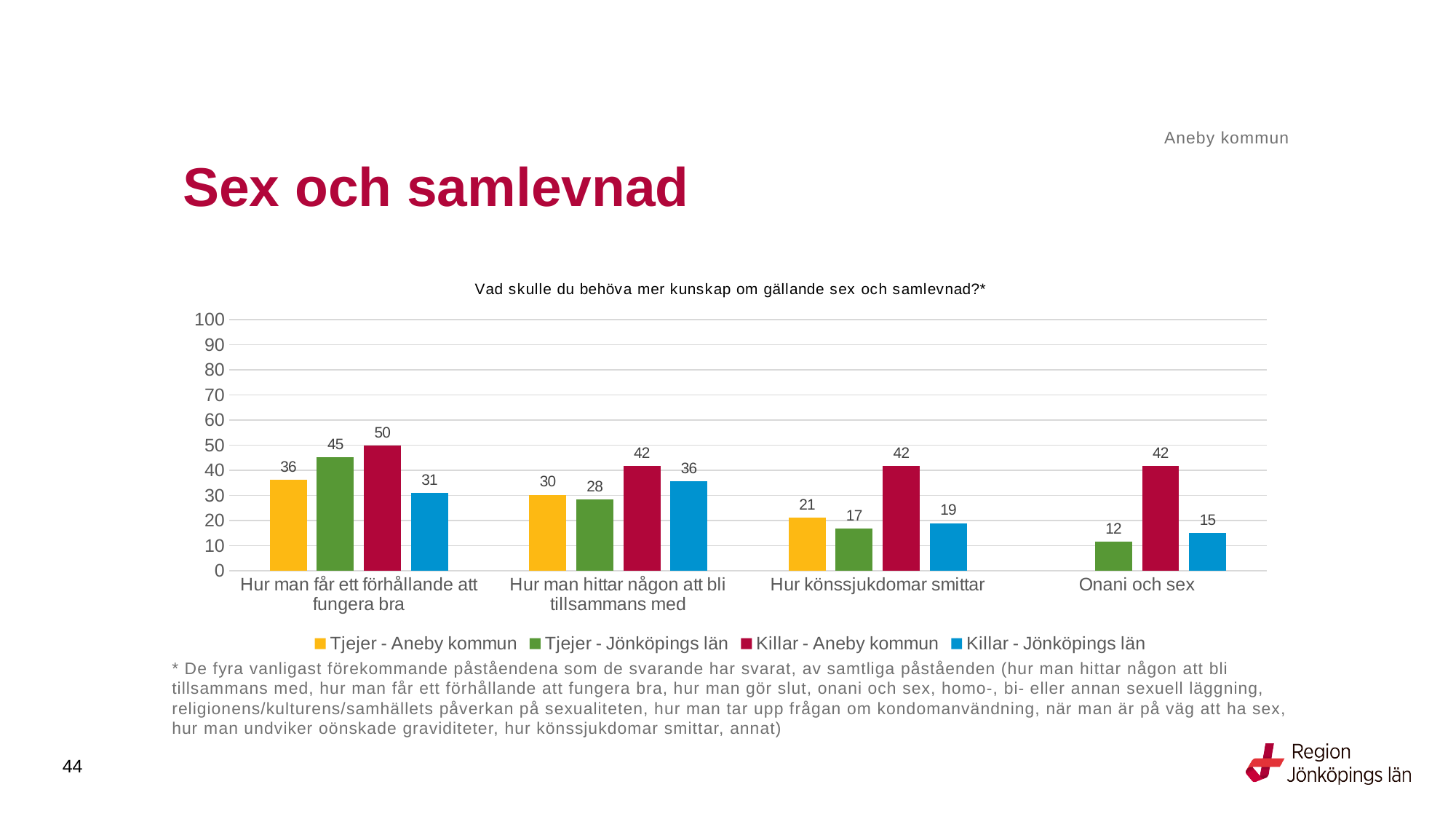
How many series does the legend list? 4 What is the value for Killar - Aneby kommun in the category "Hur man får ett förhållande att fungera bra"? 50 What is the value for Tjejer - Jönköpings län in the category "Hur man hittar någon att bli tillsammans med"? 28 What is the value for Killar - Jönköpings län in the category "Onani och sex"? 15 What kind of chart is shown on the slide? Bar chart Which series has the lowest value in the category "Hur könssjukdomar smittar"? Tjejer - Jönköpings län What is the value for Tjejer - Aneby kommun in the category "Hur könssjukdomar smittar"? 21 How many categories are shown on the x axis? 4 What is the difference between the Killar - Aneby kommun and Tjejer - Aneby kommun values in the category "Hur man hittar någon att bli tillsammans med"? 12 What is the title of the chart? Vad skulle du behöva mer kunskap om gällande sex och samlevnad?* In the category "Hur man får ett förhållande att fungera bra", which is larger: Tjejer - Aneby kommun or Tjejer - Jönköpings län? Tjejer - Jönköpings län Which series has the highest value in the category "Hur man får ett förhållande att fungera bra"? Killar - Aneby kommun